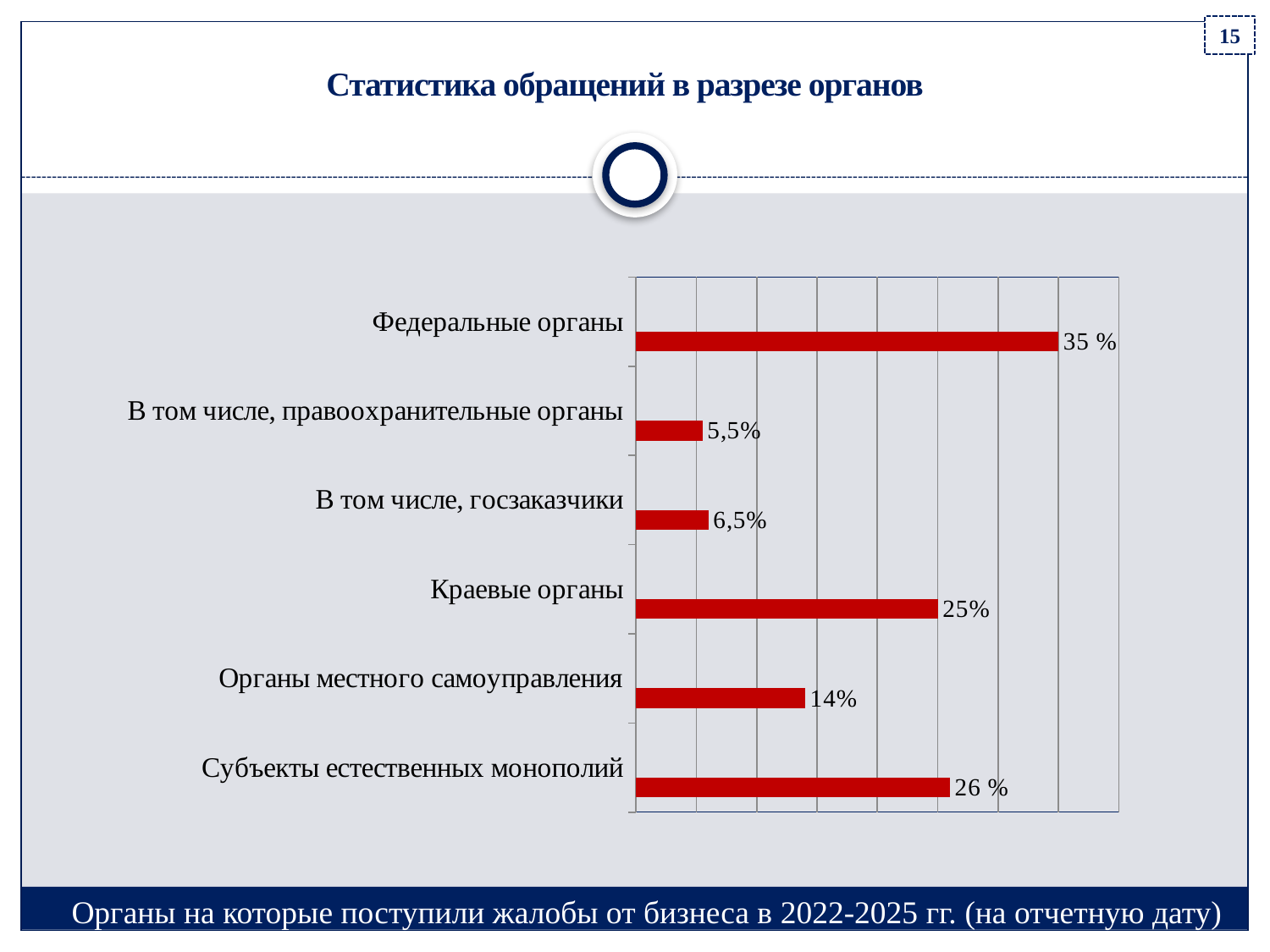
What is the difference between the values for Краевые органы and Органы местного самоуправления? 11% How many categories are shown in the chart? 6 What is the difference between the values for Федеральные органы and Субъекты естественных монополий? 9% Which is larger: the value for В том числе, госзаказчики or the value for В том числе, правоохранительные органы? В том числе, госзаказчики Which category has the lowest value? В том числе, правоохранительные органы What is the value for В том числе, правоохранительные органы? 5,5% What is the value for Федеральные органы? 35 % What is the value for Краевые органы? 25% What kind of chart is shown on the slide? Bar chart Which category has the highest value? Федеральные органы What is the value for Органы местного самоуправления? 14% What is the value for Субъекты естественных монополий? 26 %